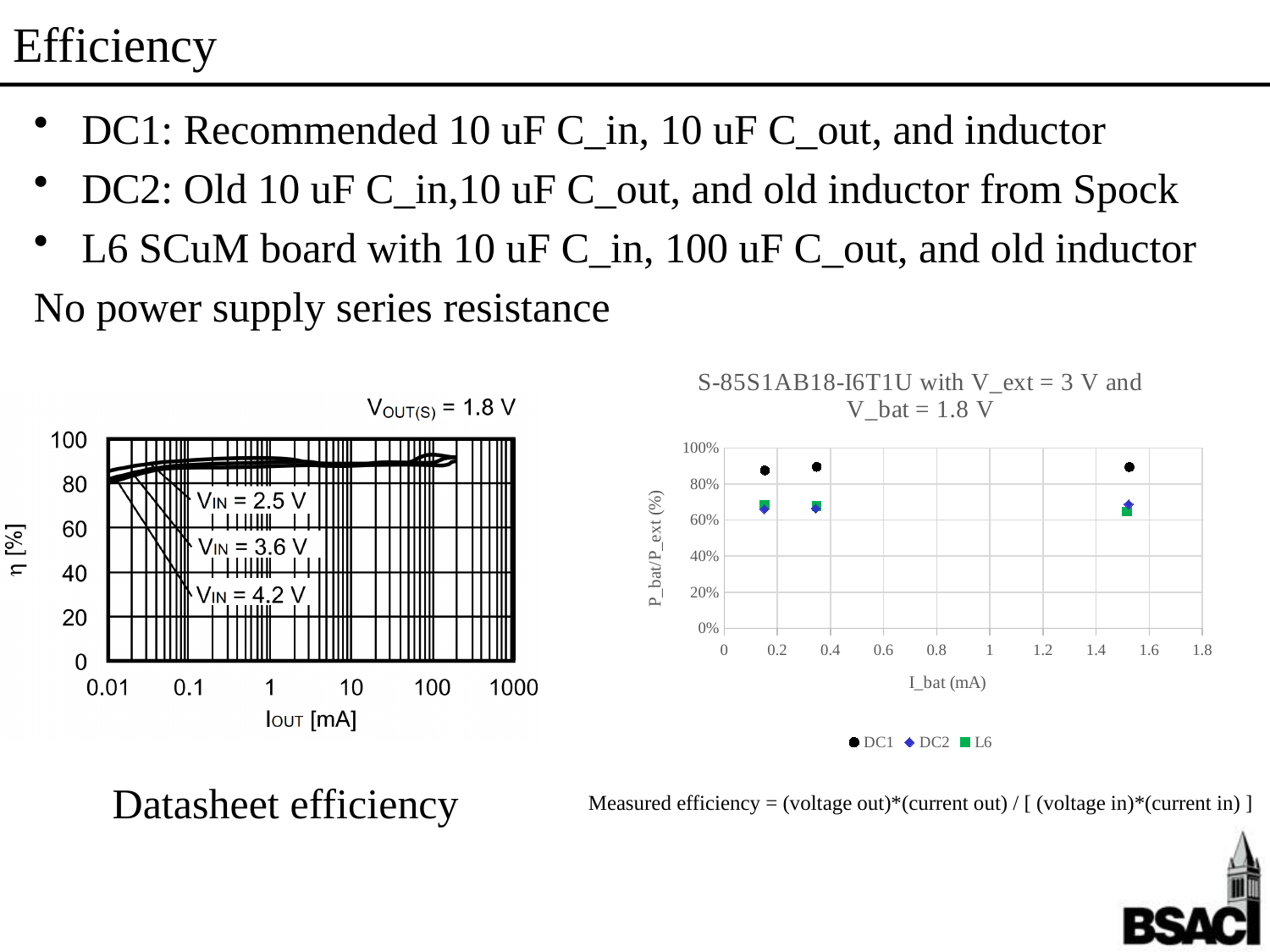
In the left-hand datasheet efficiency chart, is the efficiency at I_OUT = 1 mA greater or less than 80%? greater In the right-hand chart (S-85S1AB18-I6T1U), at about 1.5 mA, which is larger: the DC1 efficiency or the L6 efficiency? DC1 In the right-hand chart (S-85S1AB18-I6T1U), how many series does the legend list? 3 In the right-hand chart (S-85S1AB18-I6T1U), what is the label of the y axis? P_bat/P_ext (%) In the right-hand chart (S-85S1AB18-I6T1U), which series has the highest efficiency values? DC1 In the right-hand chart (S-85S1AB18-I6T1U), how many data points are plotted for the DC1 series? 3 In the left-hand datasheet efficiency chart, how many V_IN curves are plotted? 3 In the right-hand chart (S-85S1AB18-I6T1U), what are the names of the series in the legend? DC1, DC2, L6 What kind of chart is the left-hand datasheet efficiency chart? line chart What kind of chart is the right-hand chart (S-85S1AB18-I6T1U)? scatter chart In the right-hand chart (S-85S1AB18-I6T1U), is the DC1 efficiency at about 1.5 mA greater or less than 80%? greater In the right-hand chart (S-85S1AB18-I6T1U), is the DC2 efficiency at about 0.35 mA greater or less than 80%? less